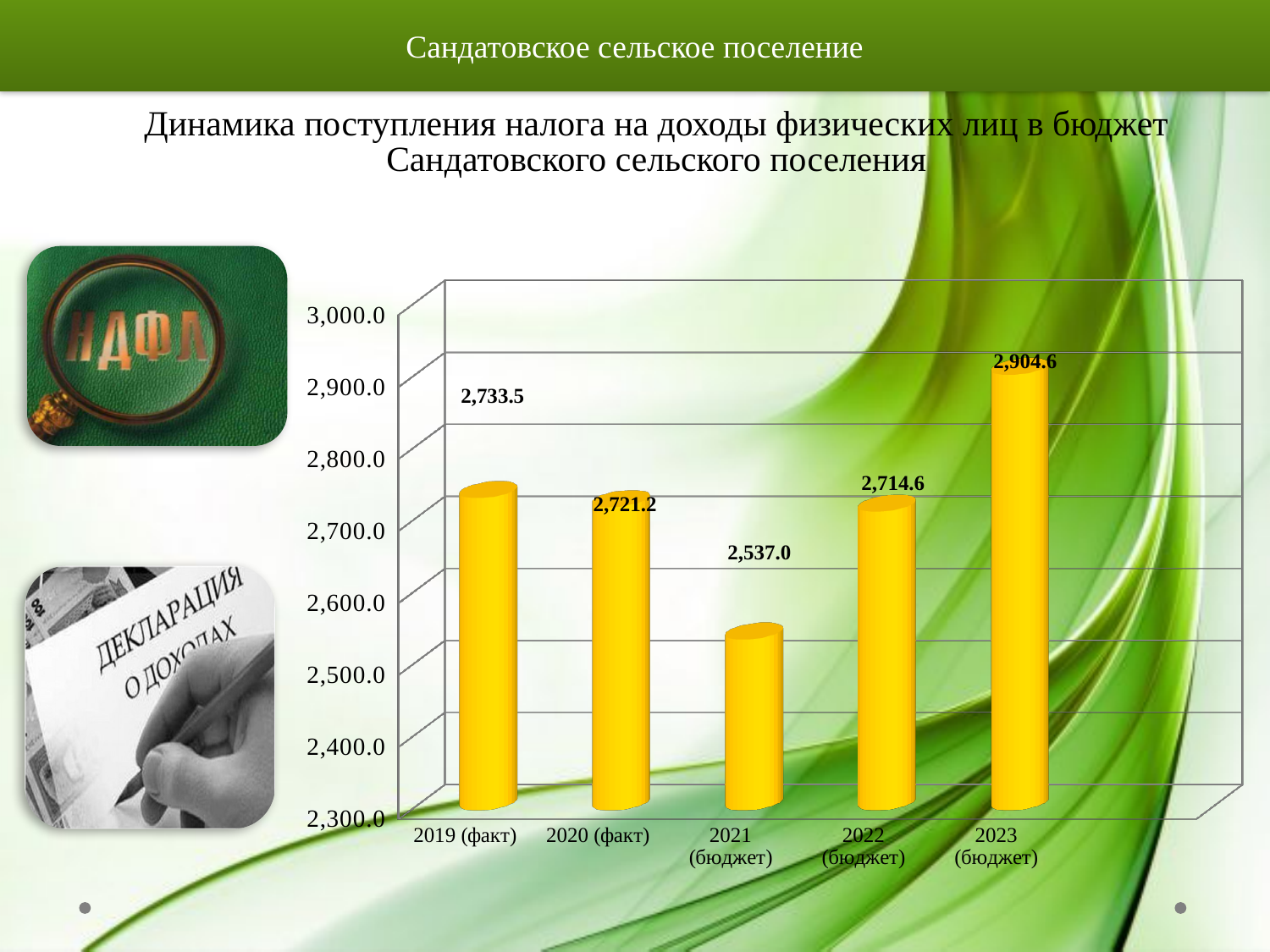
Which category has the highest value? 2023 (бюджет) How many categories are shown on the x axis? 5 What is the difference between the values for 2023 (бюджет) and 2021 (бюджет)? 367.6 Which category has the lowest value? 2021 (бюджет) Is the value for 2021 (бюджет) greater or less than 2,600.0? less What colour are the bars in the chart? yellow What is the value for 2021 (бюджет)? 2,537.0 What is the value for 2019 (факт)? 2,733.5 Which is larger, the value for 2020 (факт) or the value for 2022 (бюджет)? 2020 (факт) What is the value for 2023 (бюджет)? 2,904.6 What kind of chart is shown on the slide? bar chart What is the difference between the values for 2019 (факт) and 2020 (факт)? 12.3